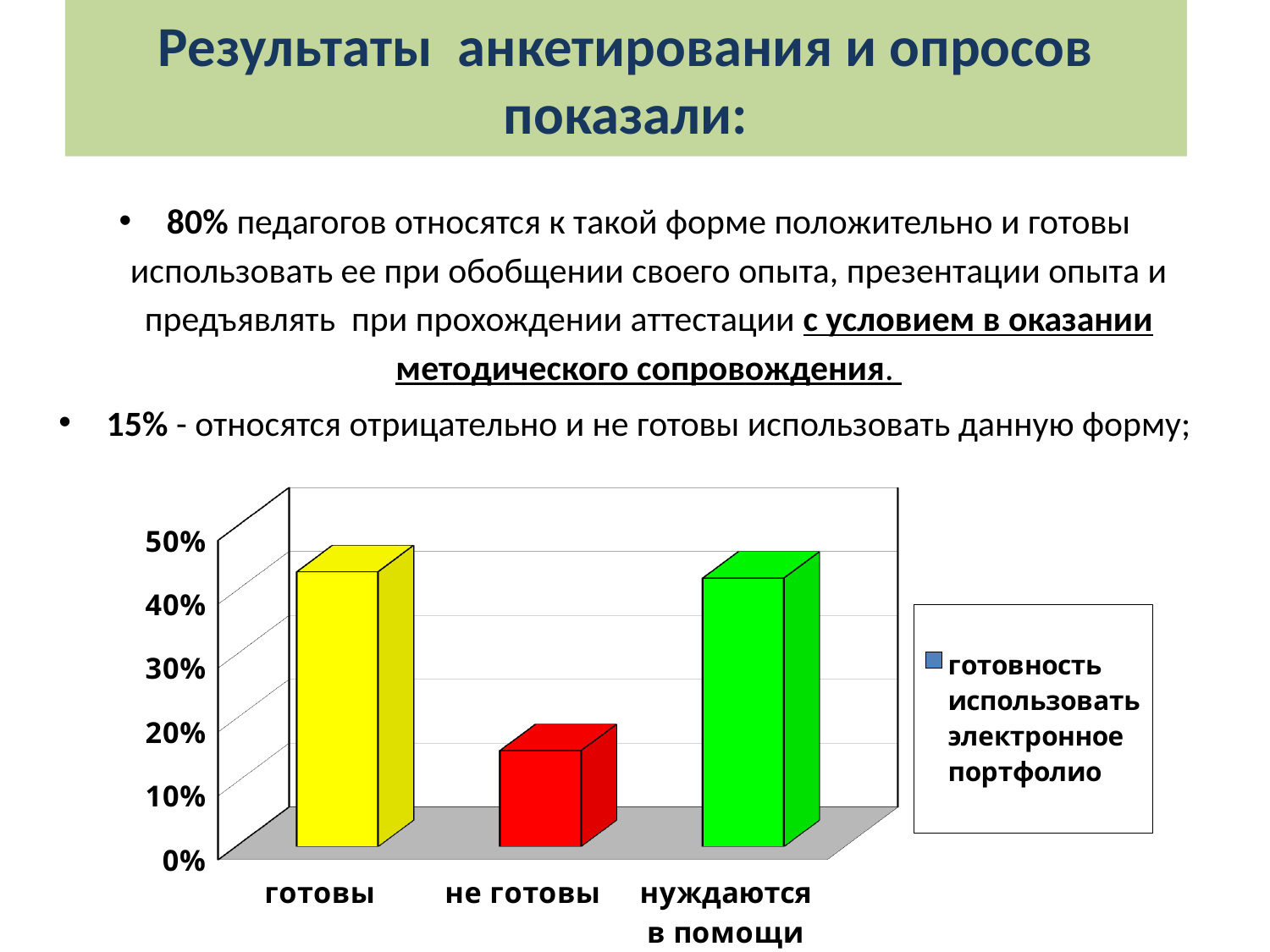
Is the value for "не готовы" greater or less than 20%? less What kind of chart is shown on the slide? bar chart Is the value for "готовы" greater or less than 40%? greater How many categories are shown on the x axis of the chart? 3 Is the value for "нуждаются в помощи" greater or less than 40%? greater How many series does the chart legend list? 1 Which is larger, the value for "нуждаются в помощи" or the value for "не готовы"? нуждаются в помощи Which category has the lowest bar in the chart? не готовы Which is larger, the value for "готовы" or the value for "не готовы"? готовы What colour is the bar for "не готовы"? red What is the series name shown in the chart legend? готовность использовать электронное портфолио